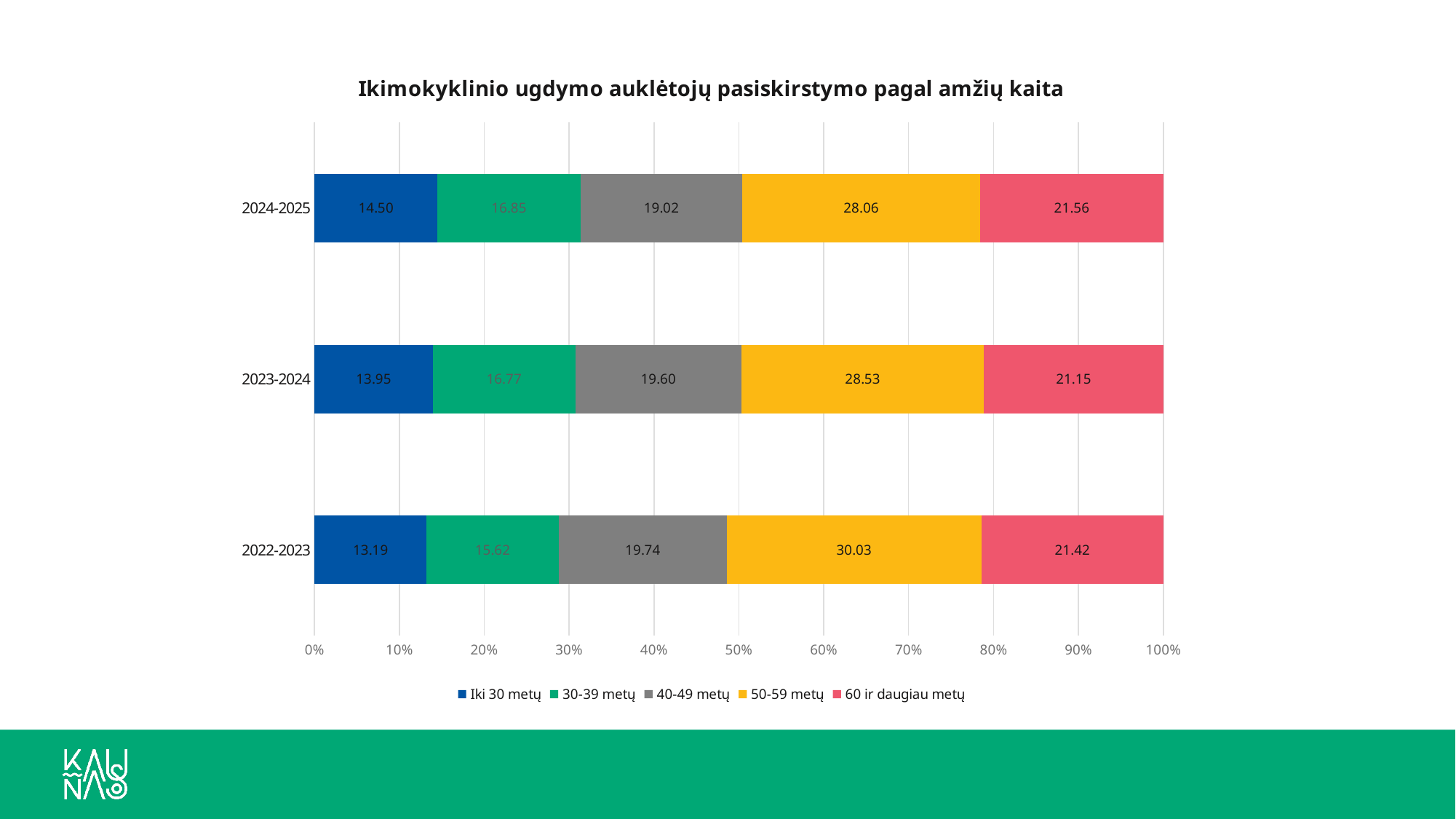
What is the value for the 40-49 metų series in the 2023-2024 bar? 19.60 Which year has the larger value for 60 ir daugiau metų, 2023-2024 or 2024-2025? 2024-2025 Which age group has the smallest segment in the 2024-2025 bar? Iki 30 metų What is the difference between the 50-59 metų value in 2022-2023 and in 2024-2025? 1.97 What is the difference between the 40-49 metų value in 2022-2023 and in 2024-2025? 0.72 What kind of chart is shown on the slide? Stacked bar chart How many series does the legend list? 5 How many school years (bars) are shown in the chart? 3 What is the value for the 50-59 metų series in the 2024-2025 bar? 28.06 Does the Iki 30 metų value rise or fall from 2022-2023 to 2024-2025? Rise Which age group has the largest segment in the 2022-2023 bar? 50-59 metų What is the value for the Iki 30 metų series in the 2022-2023 bar? 13.19